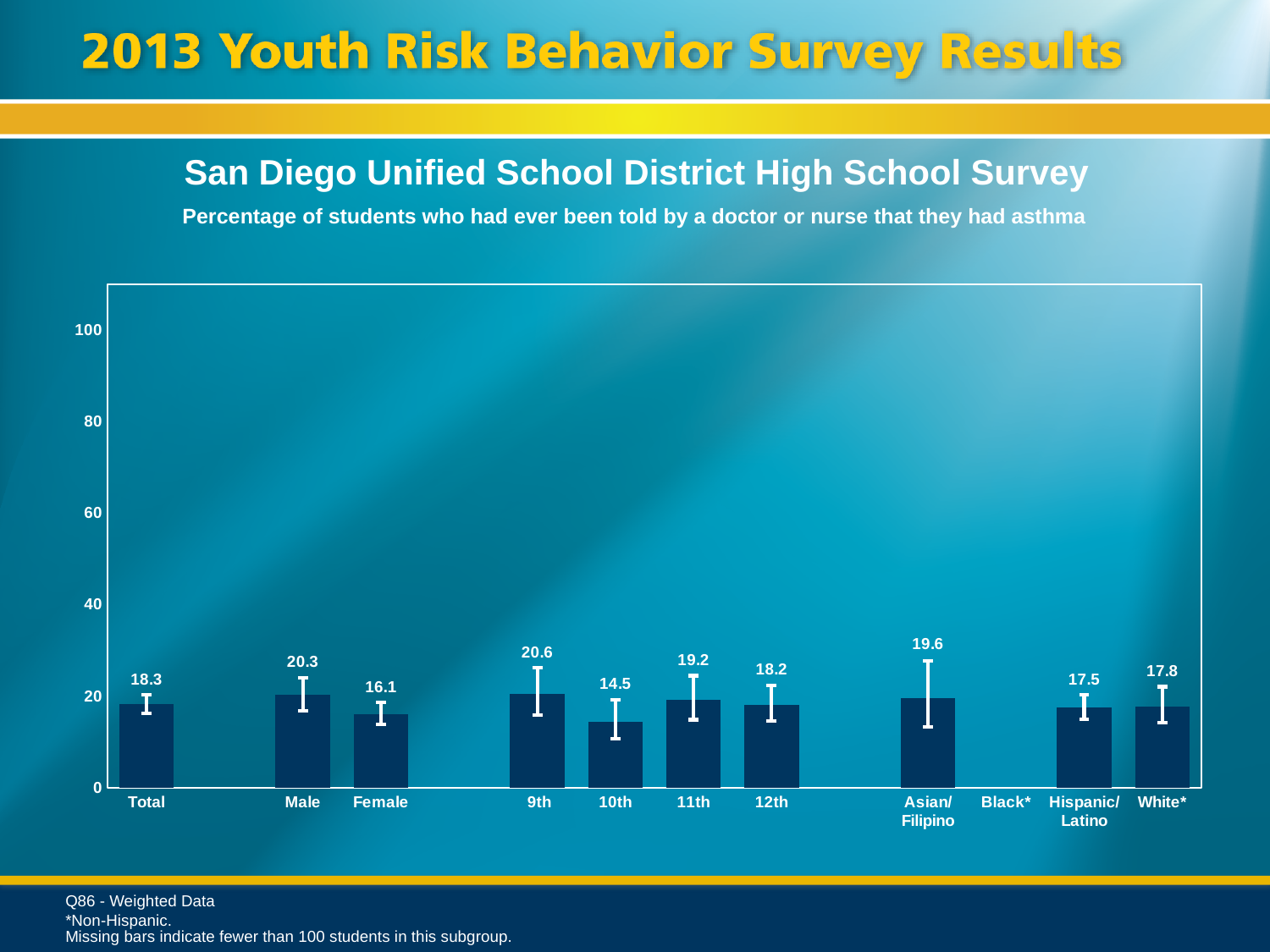
Which is larger, the value for 11th grade or the value for 12th grade? 11th What type of chart is shown on the slide? bar chart What is the value shown for 10th grade students? 14.5 What is the difference between the Male and Female values? 4.2 What percentage of students in the Total category had ever been told they had asthma? 18.3 Which category with a bar has the lowest value on the chart? 10th What is the value shown for Male students? 20.3 Which category has the highest value on the chart? 9th Is the value for Hispanic/Latino students greater or less than 20? less How many categories on the x axis have a bar plotted? 10 Which category on the x axis has no bar plotted? Black* What is the value shown for Asian/Filipino students? 19.6